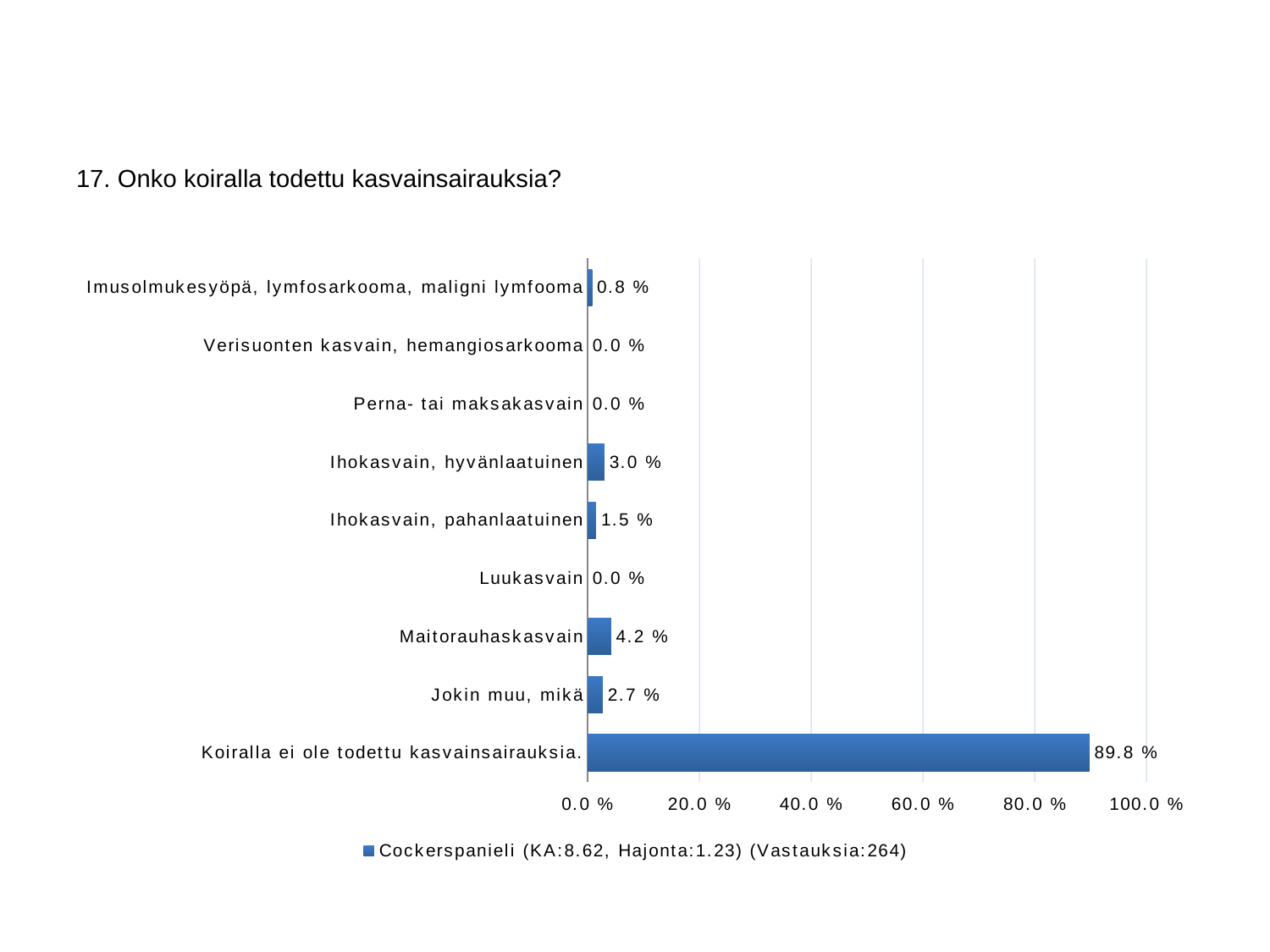
How many series does the legend list? 1 What kind of chart is shown on the slide? bar chart What is the value for "Imusolmukesyöpä, lymfosarkooma, maligni lymfooma"? 0.8 % Is the value for "Koiralla ei ole todettu kasvainsairauksia." greater or less than 80.0 %? greater How many categories have a value of 0.0 %? 3 What is the value for "Koiralla ei ole todettu kasvainsairauksia."? 89.8 % What is the value for "Ihokasvain, hyvänlaatuinen"? 3.0 % How many categories are shown on the chart? 9 Which is larger, the value for "Ihokasvain, hyvänlaatuinen" or "Ihokasvain, pahanlaatuinen"? Ihokasvain, hyvänlaatuinen Which category has the highest value? Koiralla ei ole todettu kasvainsairauksia. What is the value for "Maitorauhaskasvain"? 4.2 % What is the difference between the values for "Maitorauhaskasvain" and "Jokin muu, mikä"? 1.5 %